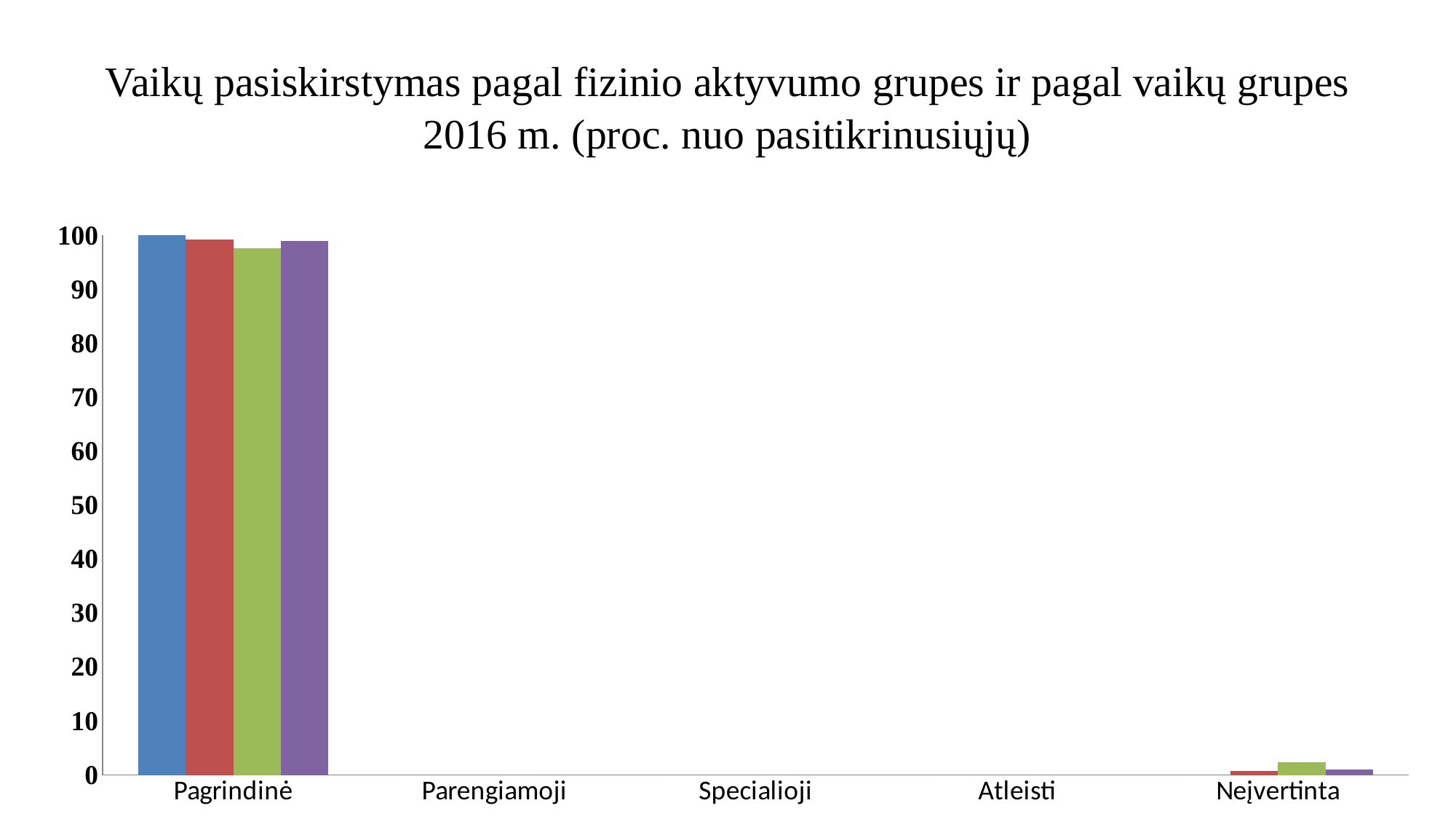
Is the value of the purple bar for Neįvertinta greater or less than 10? less Which category has larger values, Pagrindinė or Neįvertinta? Pagrindinė Which category has a larger green bar, Pagrindinė or Atleisti? Pagrindinė How many bars are plotted for the Pagrindinė category? 4 Is the value of the blue bar for Pagrindinė greater or less than 90? greater How many categories are shown on the x axis of the chart? 5 Is the value of the green bar for Neįvertinta greater or less than 10? less Which category has the highest bars in the chart? Pagrindinė What is the title of the chart? Vaikų pasiskirstymas pagal fizinio aktyvumo grupes ir pagal vaikų grupes 2016 m. (proc. nuo pasitikrinusiųjų) What is the highest value shown on the y axis of the chart? 100 What kind of chart is shown on the slide? bar chart